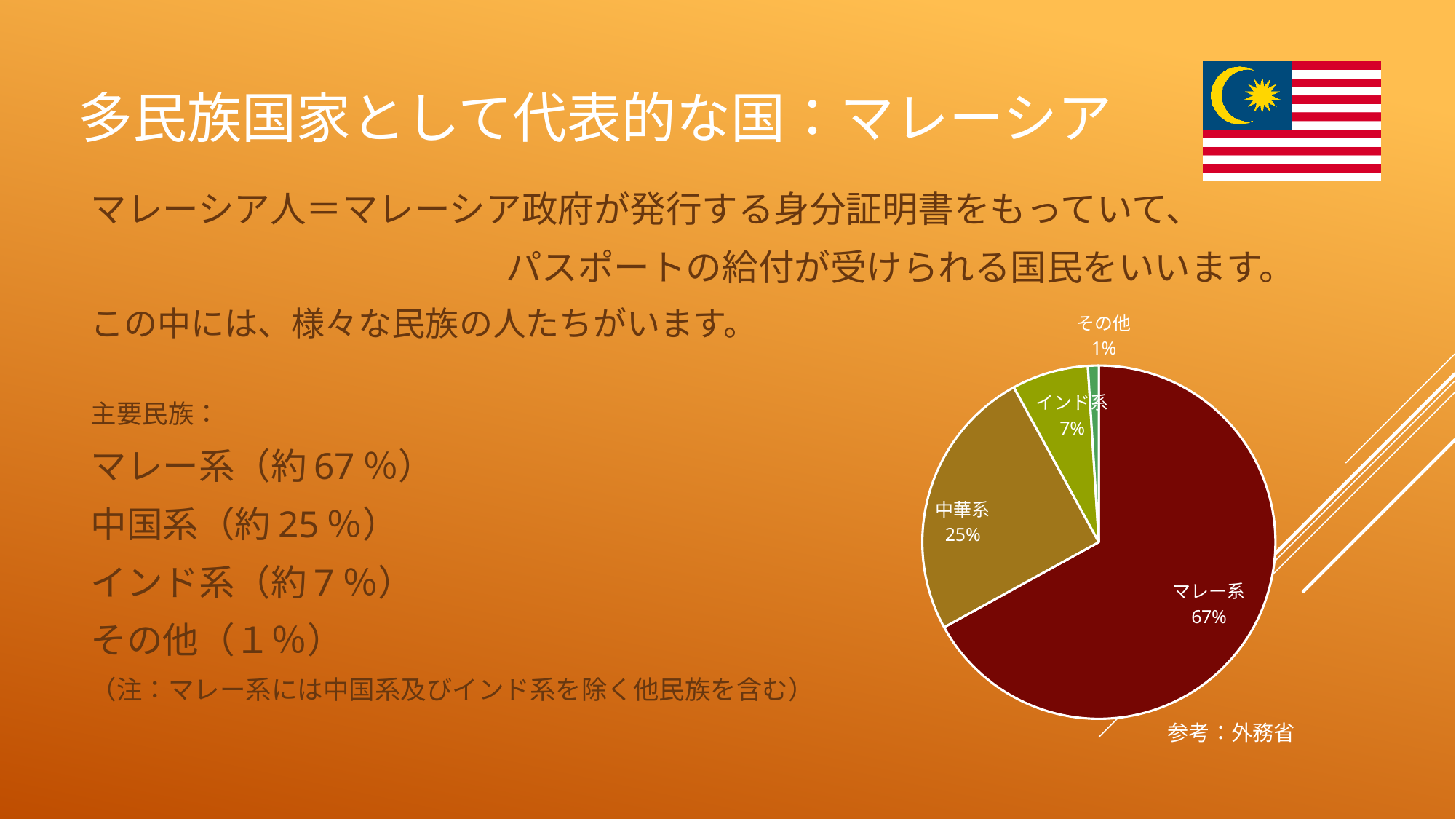
What is the value shown for その他 in the pie chart? 1% What share of the pie does the インド系 slice represent? 7% Which is larger in the pie chart, 中華系 or インド系? 中華系 What source is cited below the pie chart? 外務省 Which slice of the pie chart is the largest? マレー系 Which slice of the pie chart is the smallest? その他 What is the value shown for マレー系 in the pie chart? 67% How many slices does the pie chart have? 4 What is the value shown for 中華系 in the pie chart? 25% What is the value shown for インド系 in the pie chart? 7% What kind of chart is shown on the slide? pie chart What is the difference between the values for マレー系 and 中華系 in the pie chart? 42%